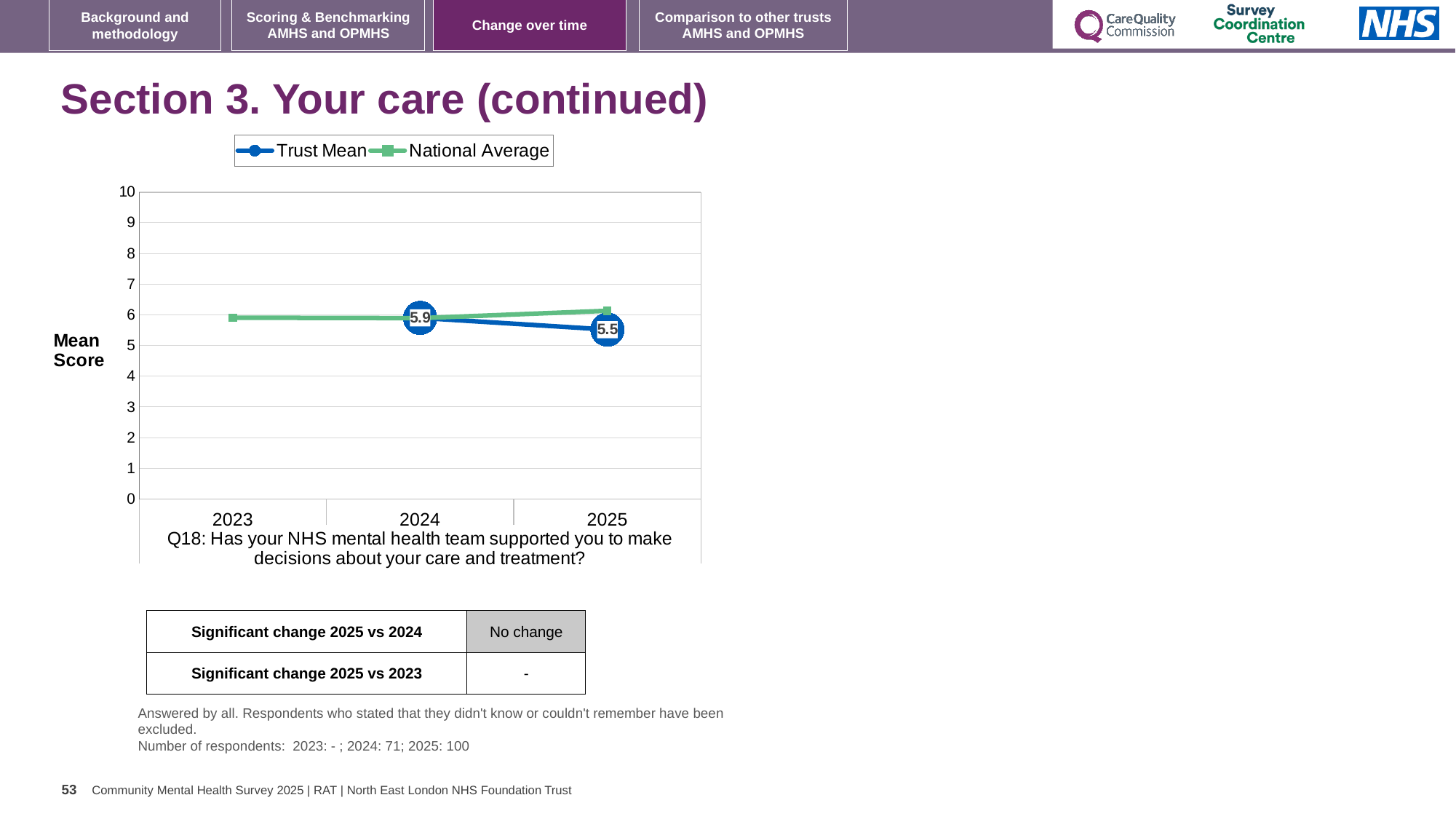
What is the label on the y axis of the chart? Mean Score Is the National Average value for 2025 greater or less than 5? greater What is the Trust Mean score for 2025? 5.5 By how much did the Trust Mean score change from 2024 to 2025? 0.4 Is the National Average value for 2023 greater or less than 7? less What kind of chart is shown on the slide? line chart Which year has the higher Trust Mean score, 2024 or 2025? 2024 How many series does the legend list? 2 Does the Trust Mean rise or fall from 2024 to 2025? fall In 2025, which is higher, the Trust Mean or the National Average? National Average How many years are shown on the x axis? 3 What is the Trust Mean score for 2024? 5.9